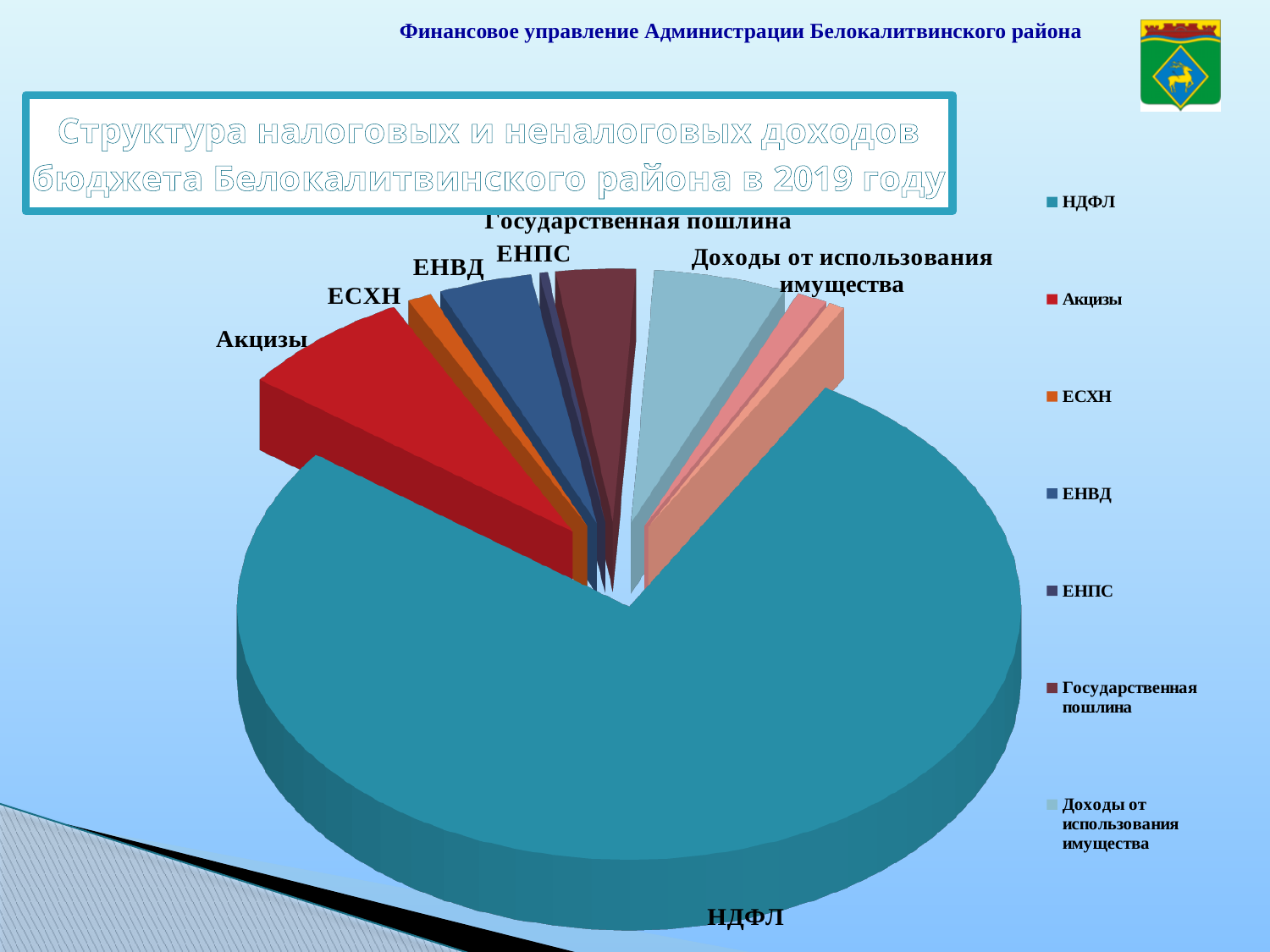
Which slice is larger, ЕНВД or ЕНПС? ЕНВД How many entries does the legend list? 7 Which slice is larger, Акцизы or ЕНВД? Акцизы Which category has the largest slice of the pie? НДФЛ Which slice is larger, Акцизы or ЕСХН? Акцизы What is the title of the chart? Структура налоговых и неналоговых доходов бюджета Белокалитвинского района в 2019 году What colour is the НДФЛ slice? teal What kind of chart is shown on the slide? pie chart